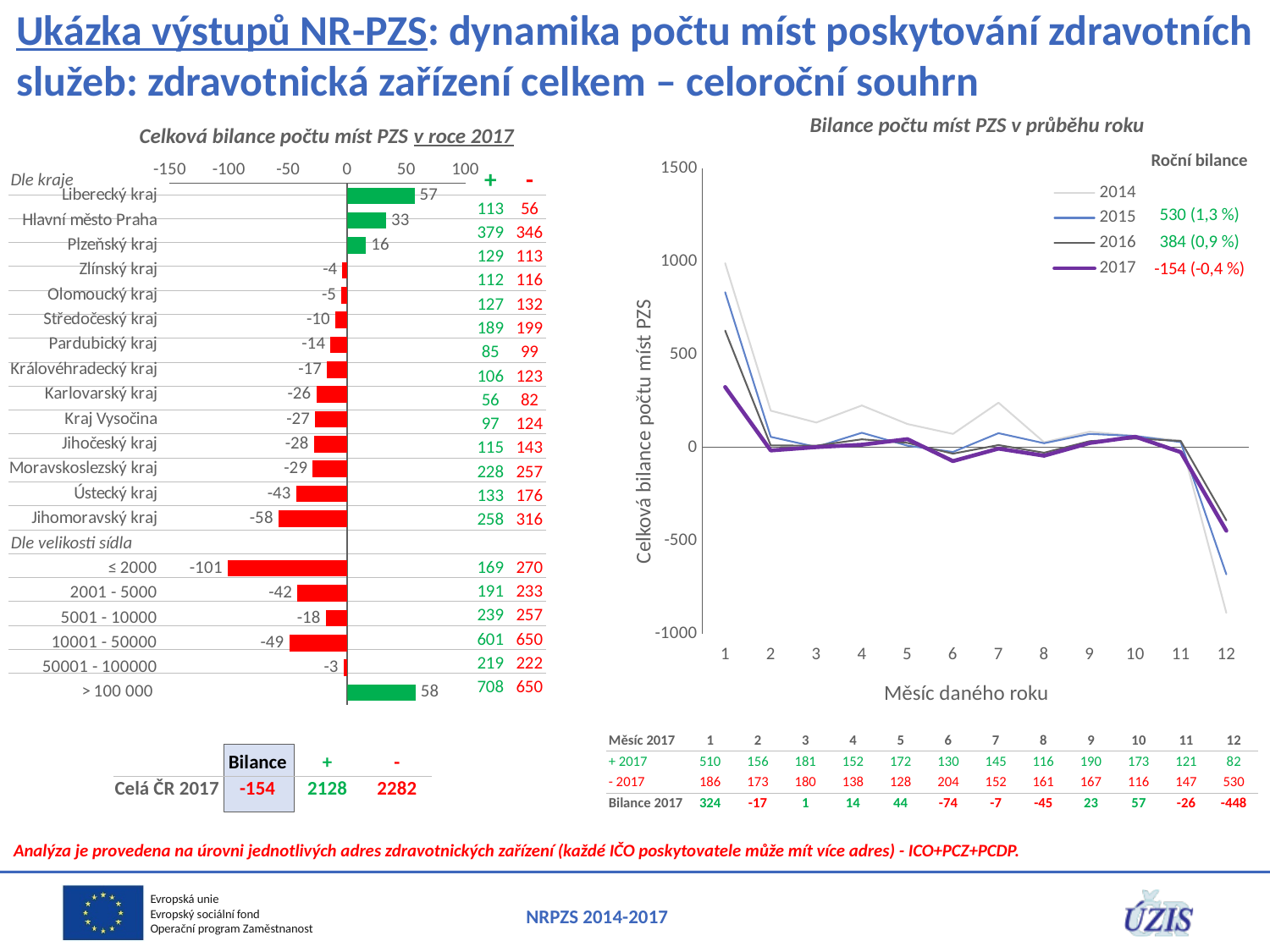
In the chart 'Bilance počtu míst PZS v průběhu roku', what is the 2017 balance (Bilance 2017) for month 12 according to the table below the chart? -448 How many series does the legend of the chart 'Bilance počtu míst PZS v průběhu roku' list? 4 In the chart 'Bilance počtu míst PZS v průběhu roku', is the value for 2014 in month 1 greater or less than 500? greater In the chart 'Celková bilance počtu míst PZS v roce 2017', what is the value for the category '> 100 000'? 58 In the chart 'Celková bilance počtu míst PZS v roce 2017', what is the difference between the values for Liberecký kraj and Hlavní město Praha? 24 In the chart 'Celková bilance počtu míst PZS v roce 2017', what is the value for Liberecký kraj? 57 In the chart 'Celková bilance počtu míst PZS v roce 2017', which settlement-size category (Dle velikosti sídla) has the lowest value? ≤ 2000 What kind of chart is 'Celková bilance počtu míst PZS v roce 2017'? Bar chart What kind of chart is 'Bilance počtu míst PZS v průběhu roku'? Line chart In the chart 'Celková bilance počtu míst PZS v roce 2017', which region (Dle kraje) has the highest value? Liberecký kraj In the chart 'Celková bilance počtu míst PZS v roce 2017', which is larger, the value for Ústecký kraj or the value for Karlovarský kraj? Karlovarský kraj In the chart 'Celková bilance počtu míst PZS v roce 2017', what is the value for Jihomoravský kraj? -58